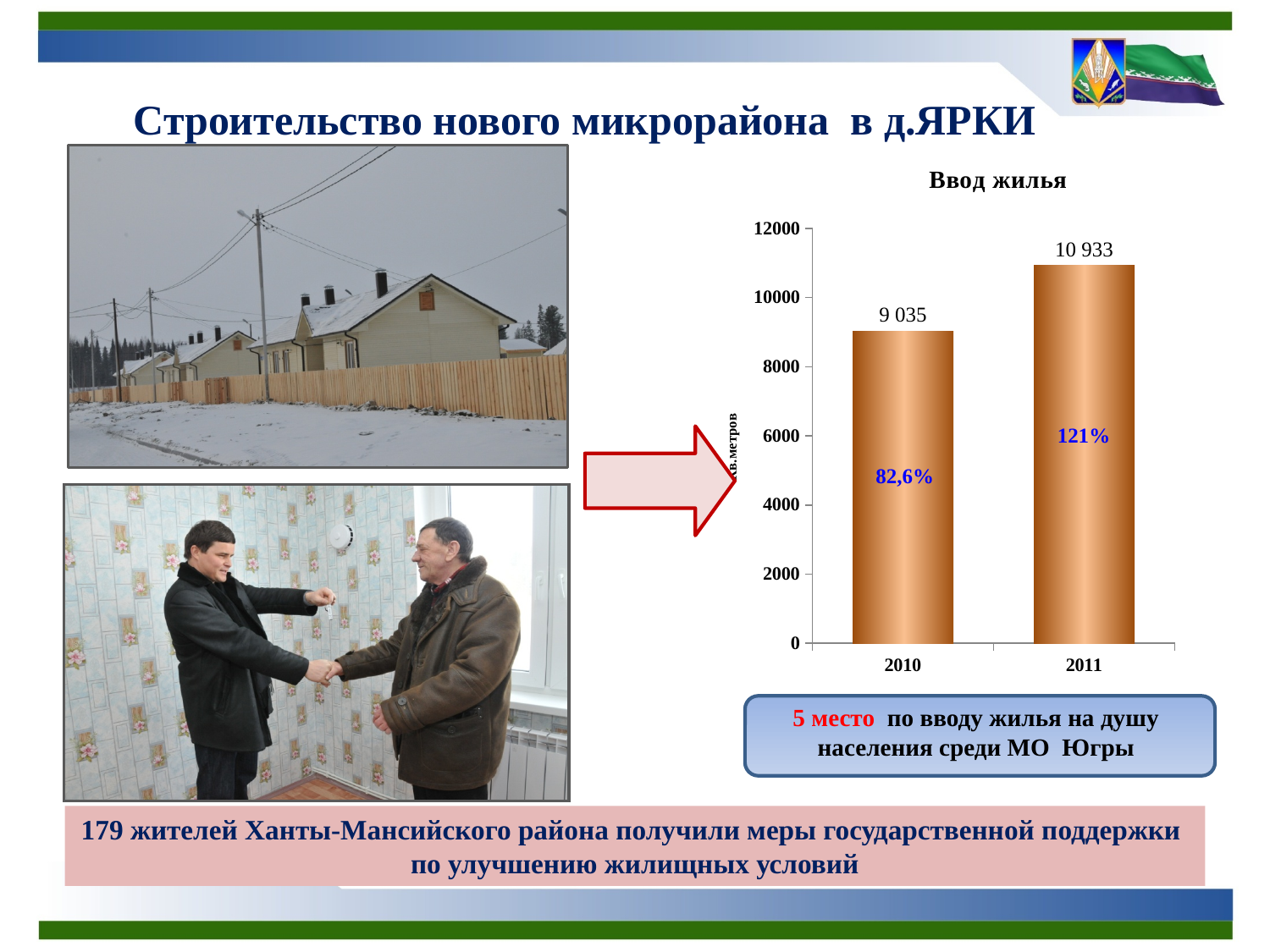
What is the value for 2010 in the 'Ввод жилья' chart? 9 035 What is the title of the chart on the slide? Ввод жилья What percentage label is printed inside the 2011 bar of the 'Ввод жилья' chart? 121% In the 'Ввод жилья' chart, is the value for 2011 larger or smaller than the value for 2010? larger What kind of chart is 'Ввод жилья'? bar chart Is the value for 2010 in the 'Ввод жилья' chart greater or less than 10000? less Which year has the lowest value in the 'Ввод жилья' chart? 2010 Do the values in the 'Ввод жилья' chart rise or fall from 2010 to 2011? rise Which year has the highest value in the 'Ввод жилья' chart? 2011 What is the value for 2011 in the 'Ввод жилья' chart? 10 933 What is the difference between the 2011 and 2010 values in the 'Ввод жилья' chart? 1 898 How many bars are shown in the 'Ввод жилья' chart? 2